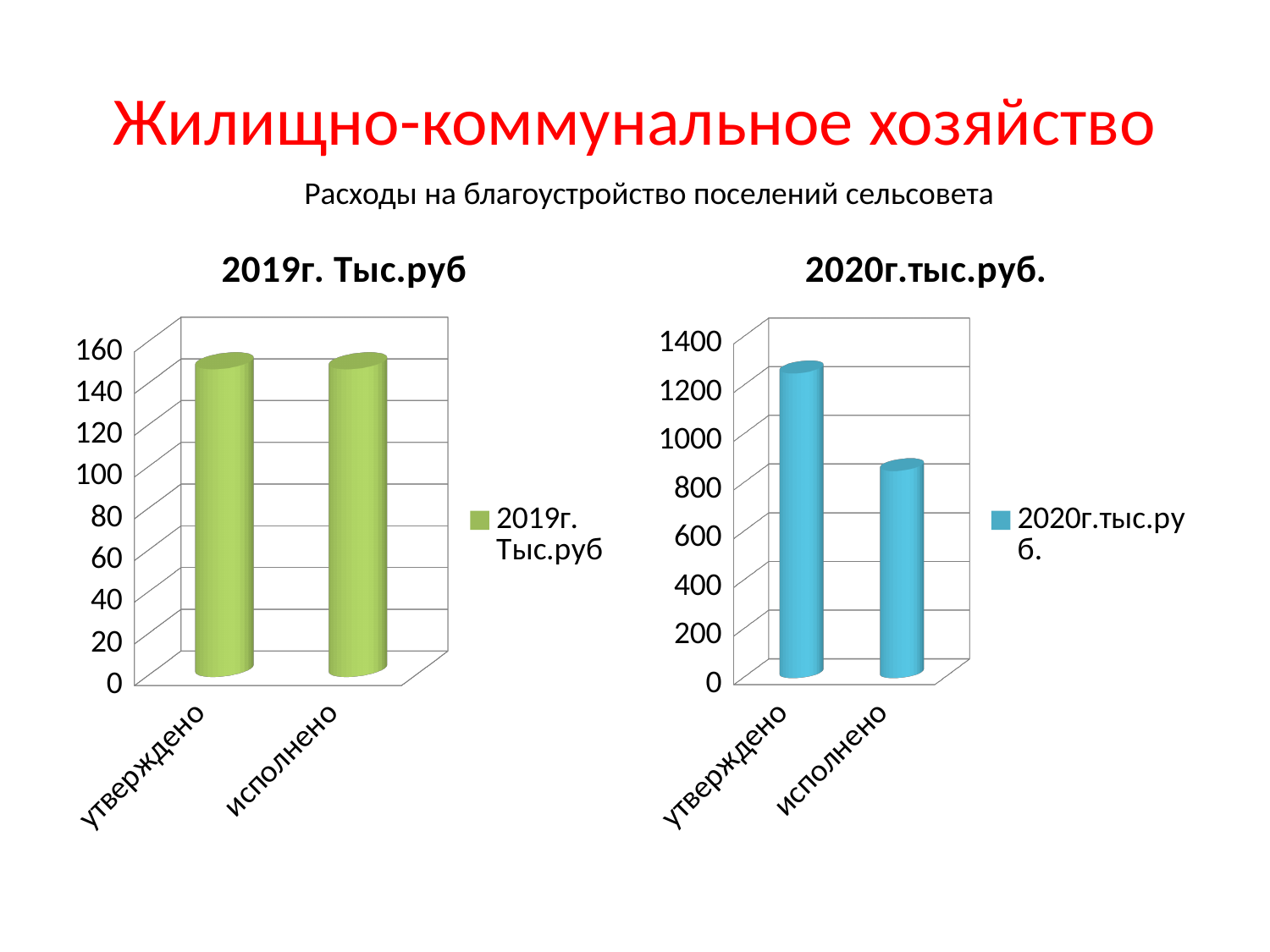
In the chart titled "2020г.тыс.руб.", which category has the highest value? утверждено In the chart titled "2019г. Тыс.руб", is the value for утверждено greater or less than 100? greater How many series does the legend of the chart titled "2020г.тыс.руб." list? 1 In the chart titled "2020г.тыс.руб.", is the value for исполнено greater or less than 1000? less What kind of chart is the chart titled "2020г.тыс.руб."? bar chart What kind of chart is the chart titled "2019г. Тыс.руб"? bar chart How many categories are shown on the x axis of the chart titled "2019г. Тыс.руб"? 2 In the chart titled "2020г.тыс.руб.", which category has the lowest value? исполнено In the chart titled "2020г.тыс.руб.", which is larger: утверждено or исполнено? утверждено In the chart titled "2020г.тыс.руб.", is the value for утверждено greater or less than 1000? greater